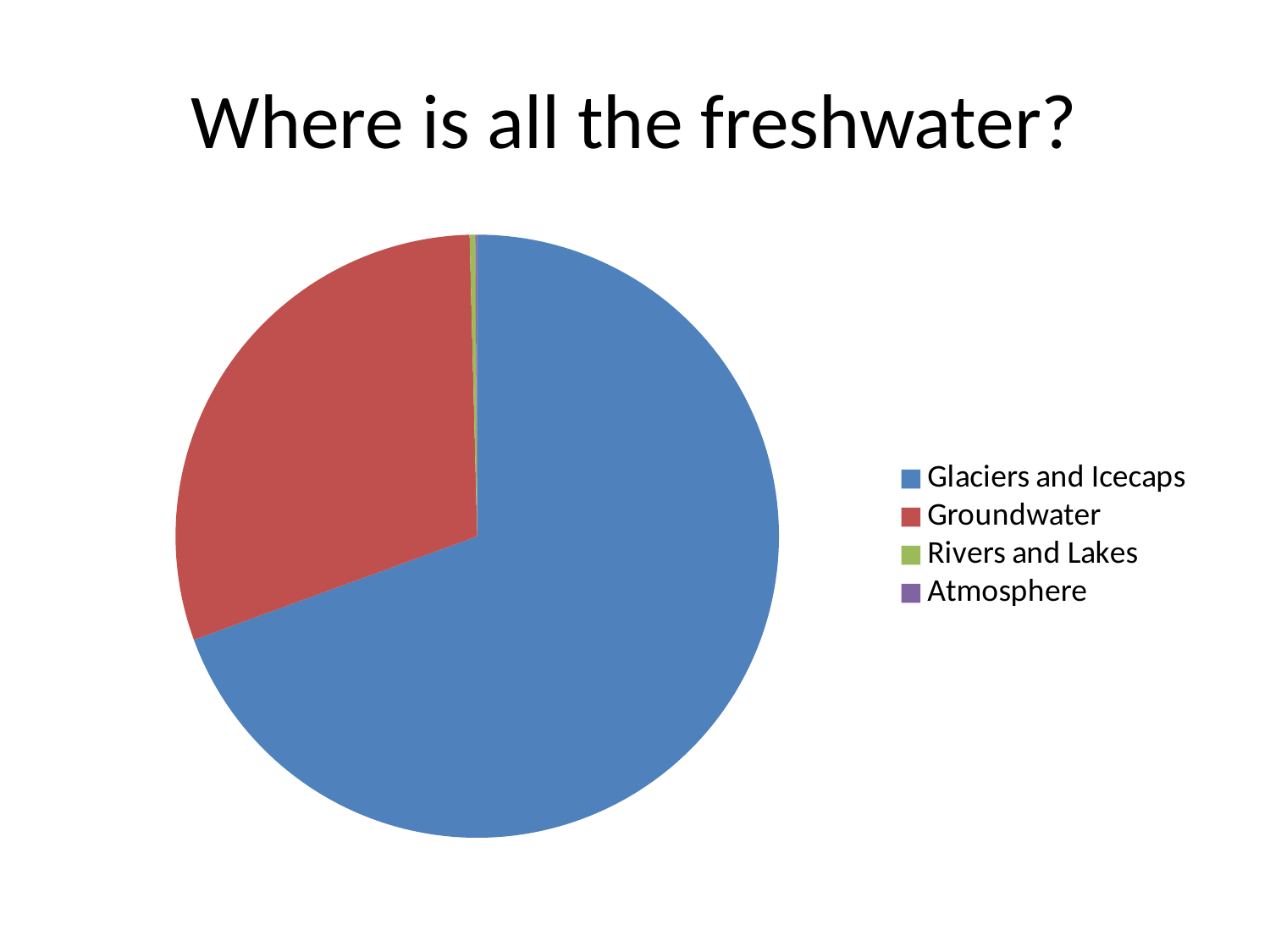
How many categories does the pie chart show? 4 Which is larger, the slice for Glaciers and Icecaps or the slice for Groundwater? Glaciers and Icecaps What kind of chart is shown on the slide? pie chart Which category has the second-largest slice of the pie? Groundwater Which is larger, the slice for Groundwater or the slice for Rivers and Lakes? Groundwater What is the title of the slide? Where is all the freshwater? Which category has the largest slice of the pie? Glaciers and Icecaps Which is larger, the slice for Glaciers and Icecaps or the slice for Atmosphere? Glaciers and Icecaps Which category is shown in red on the pie chart? Groundwater